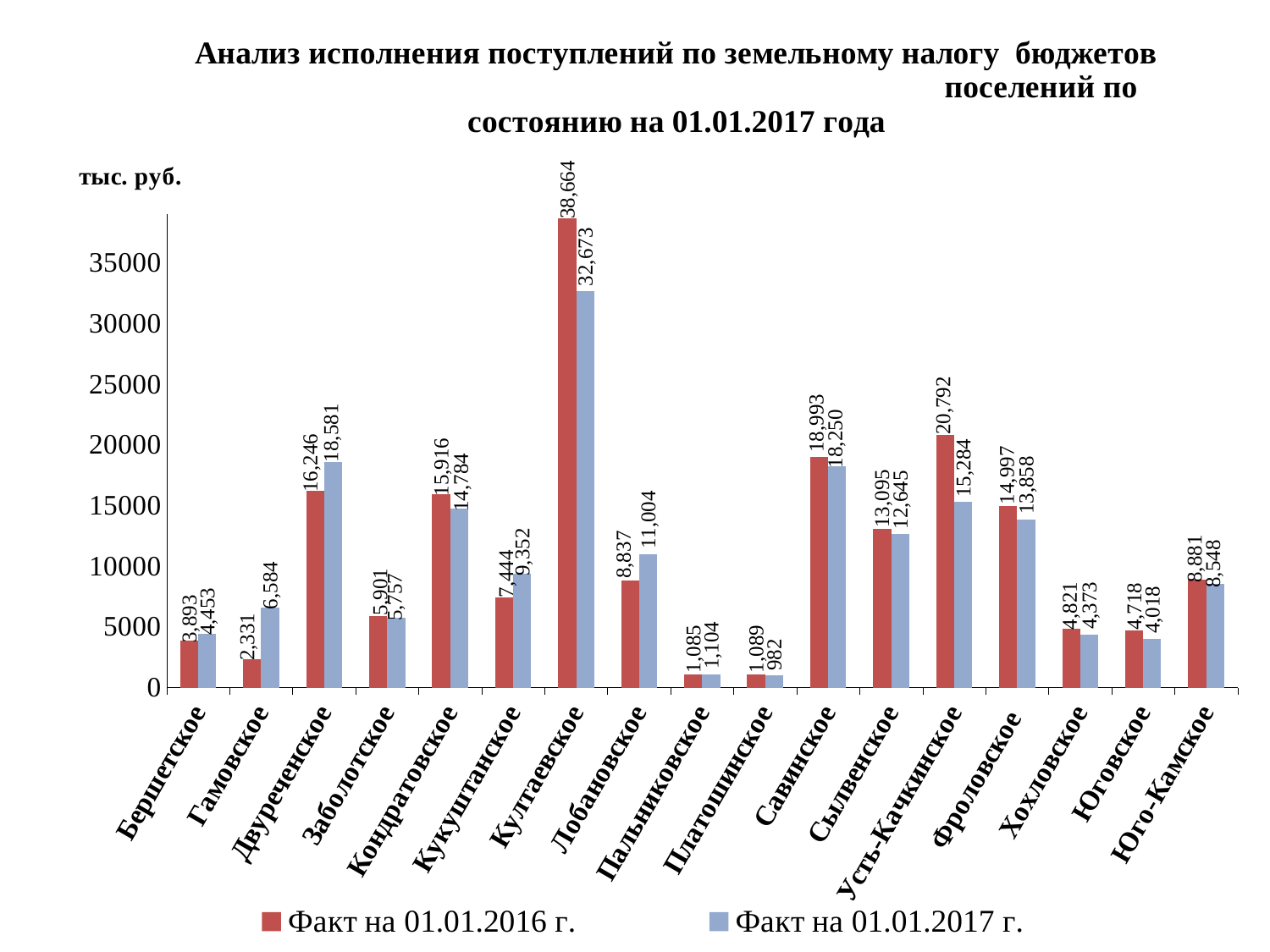
For Лобановское, which is larger: the value for Факт на 01.01.2016 г. or Факт на 01.01.2017 г.? Факт на 01.01.2017 г. How many series does the legend list? 2 Is the value for Савинское in the series Факт на 01.01.2017 г. greater or less than 15000? greater How many settlements (categories) are shown on the x axis? 17 What type of chart is shown on the slide? bar chart What is the value for Гамовское in the series Факт на 01.01.2017 г.? 6,584 What is the value for Култаевское in the series Факт на 01.01.2016 г.? 38,664 What unit of measurement is indicated above the y axis? тыс. руб. What is the difference between the 2016 and 2017 values for Култаевское? 5,991 What is the value for Усть-Качкинское in the series Факт на 01.01.2017 г.? 15,284 Which settlement has the lowest value in the series Факт на 01.01.2017 г.? Платошинское Which settlement has the highest value in the series Факт на 01.01.2016 г.? Култаевское